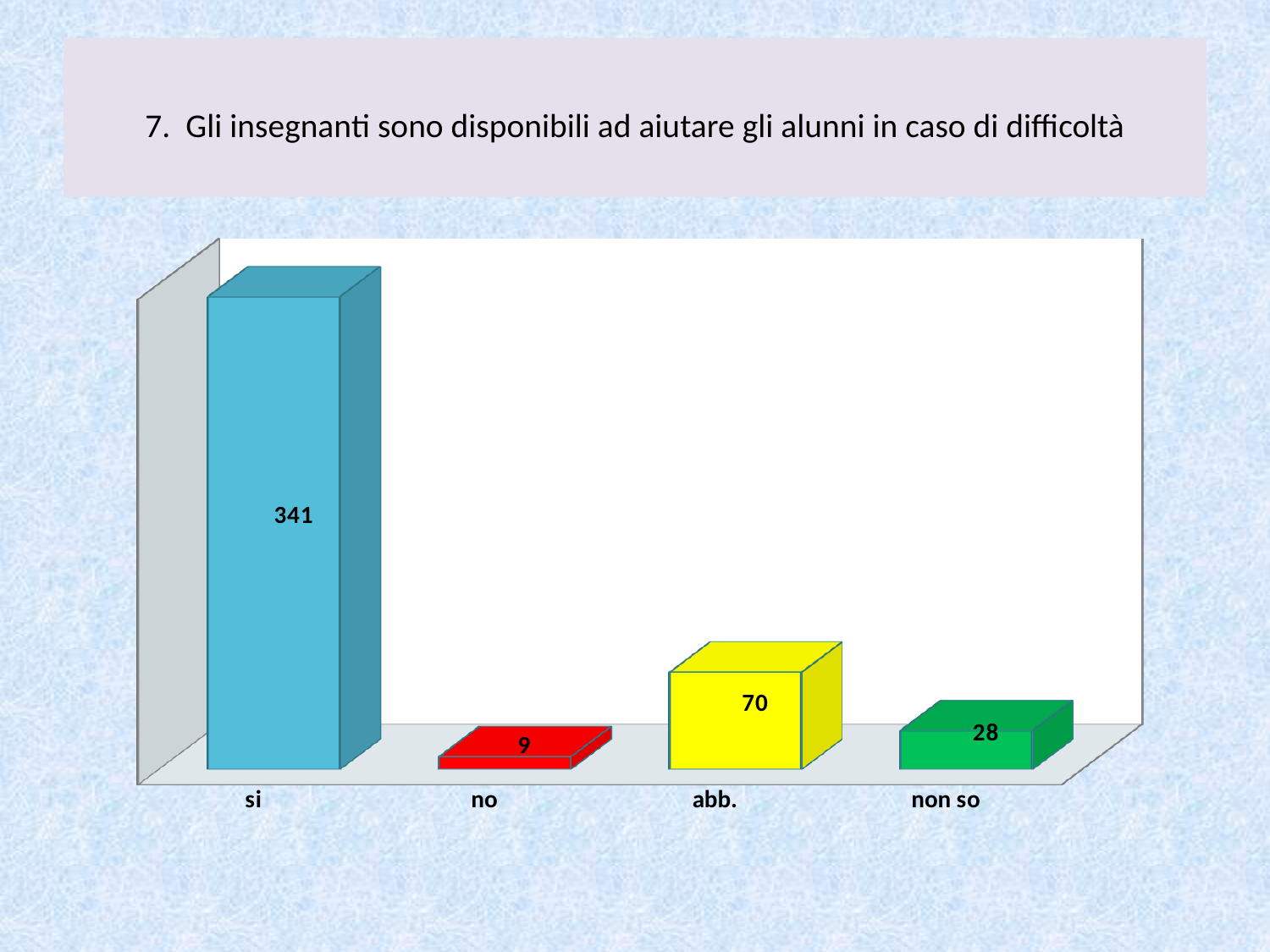
How many categories are shown in the chart? 4 What is the value for "si"? 341 What is the value for "abb."? 70 Which category has the lowest value? no What is the value for "no"? 9 What kind of chart is shown on the slide? bar chart What is the difference between the values for "abb." and "non so"? 42 What colour is the bar for "abb."? yellow What is the difference between the values for "si" and "abb."? 271 What is the value for "non so"? 28 Which is larger, the value for "non so" or the value for "no"? non so Which category has the highest value? si